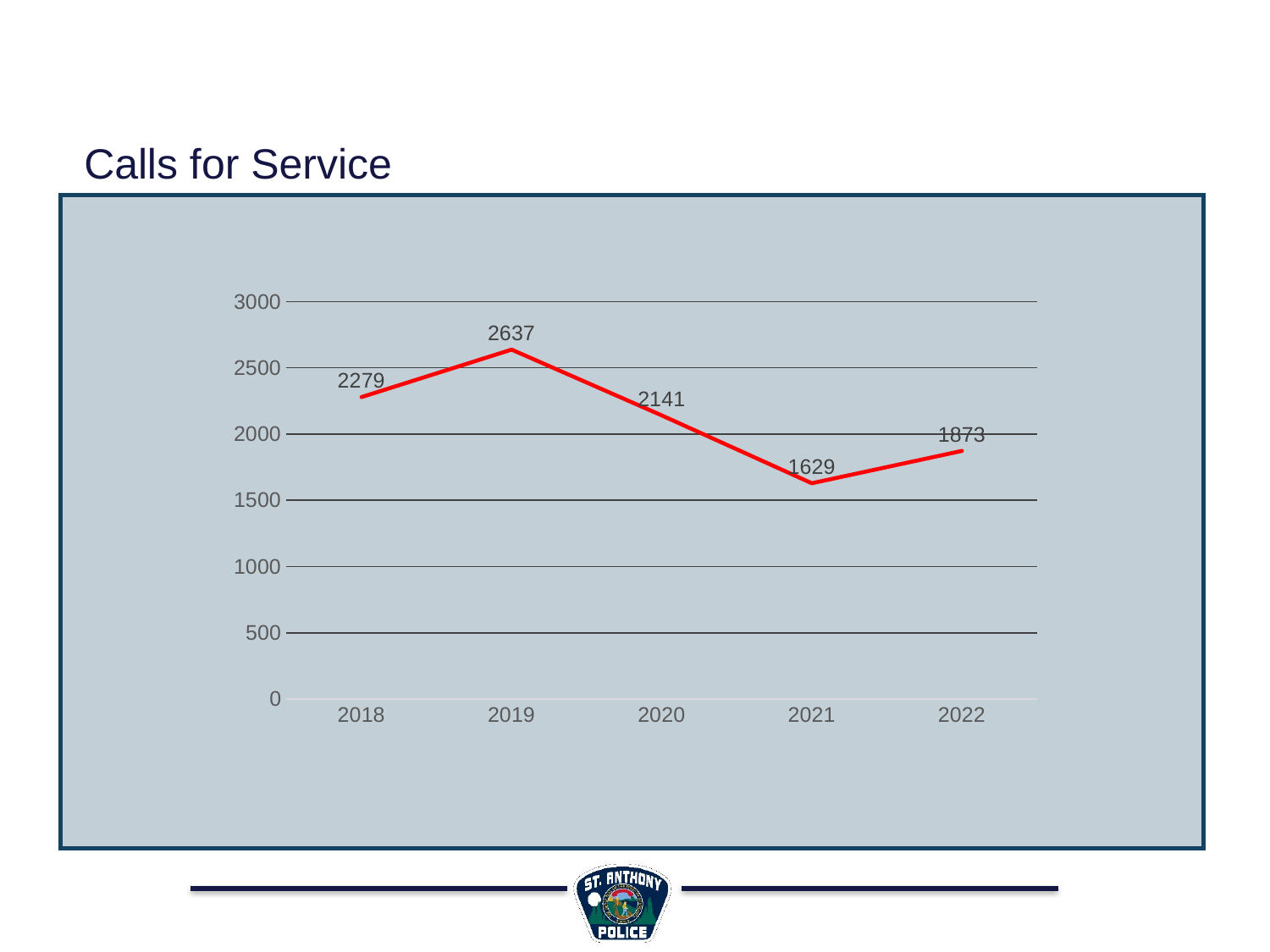
Which year has the lowest value? 2021 Which is larger, the value for 2018 or the value for 2020? 2018 Which year has the highest value? 2019 What is the value for 2018? 2279 What is the value for 2022? 1873 What kind of chart is shown? line chart What is the difference between the values for 2022 and 2021? 244 How many years are plotted on the chart? 5 What is the value for 2021? 1629 What is the difference between the values for 2019 and 2020? 496 Is the value for 2020 greater or less than 2000? greater Do the values rise or fall from 2019 to 2021? fall